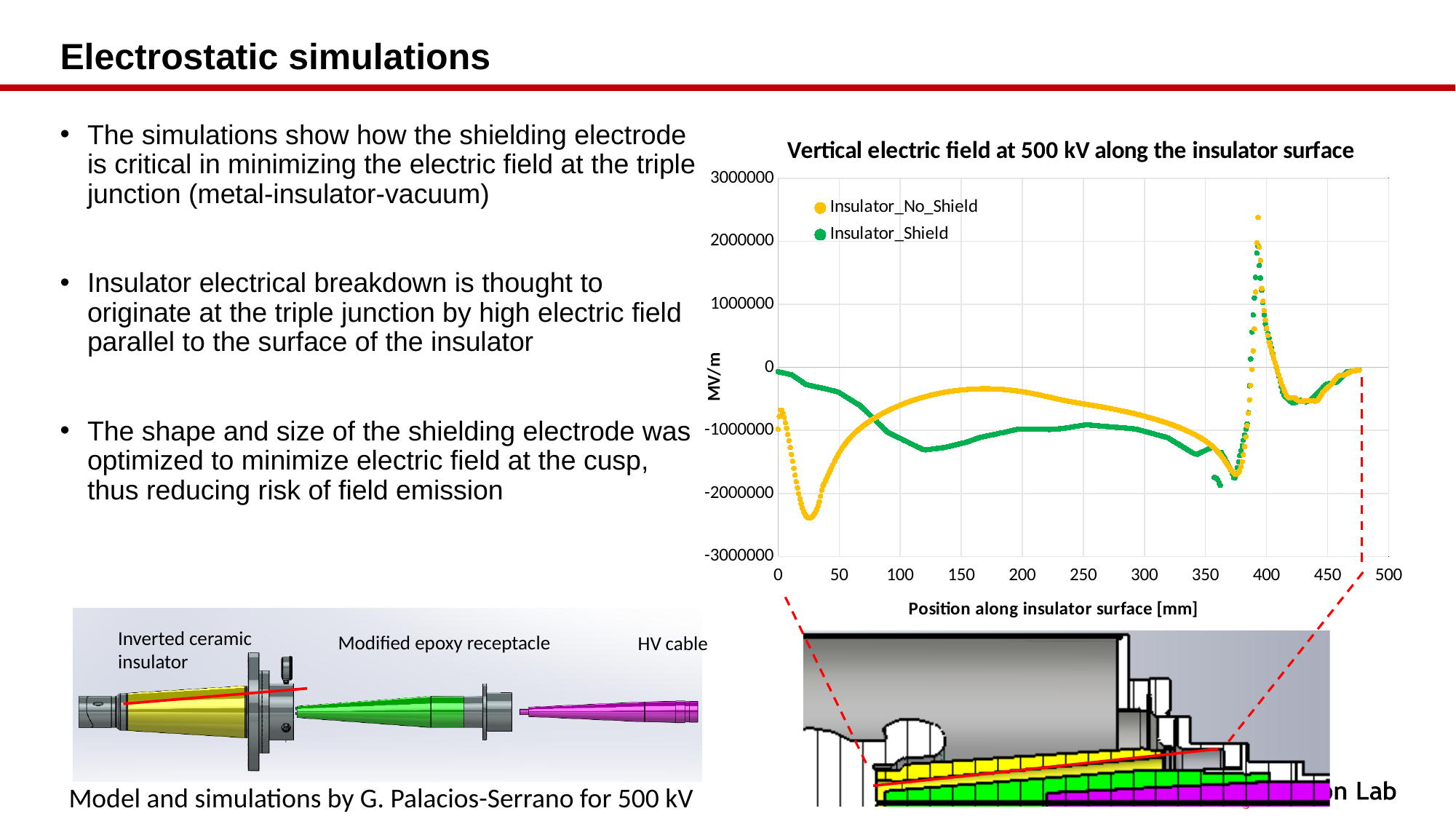
Is the value of the Insulator_No_Shield series at position 0 mm greater or less than 0? less Which series reaches the higher peak value near position 390 mm, Insulator_No_Shield or Insulator_Shield? Insulator_No_Shield Is the value of the Insulator_Shield series at position 0 mm greater or less than -1000000? greater What is the title of the chart? Vertical electric field at 500 kV along the insulator surface Which series reaches the lower (more negative) value near position 25 mm, Insulator_No_Shield or Insulator_Shield? Insulator_No_Shield What is the label of the x axis of the chart? Position along insulator surface [mm] What kind of chart is shown on the slide? scatter chart Is the highest value of the Insulator_No_Shield series (near 390 mm) greater or less than 2000000? greater How many series does the legend of the chart list? 2 Between positions 0 mm and 120 mm, does the Insulator_Shield series rise or fall? fall